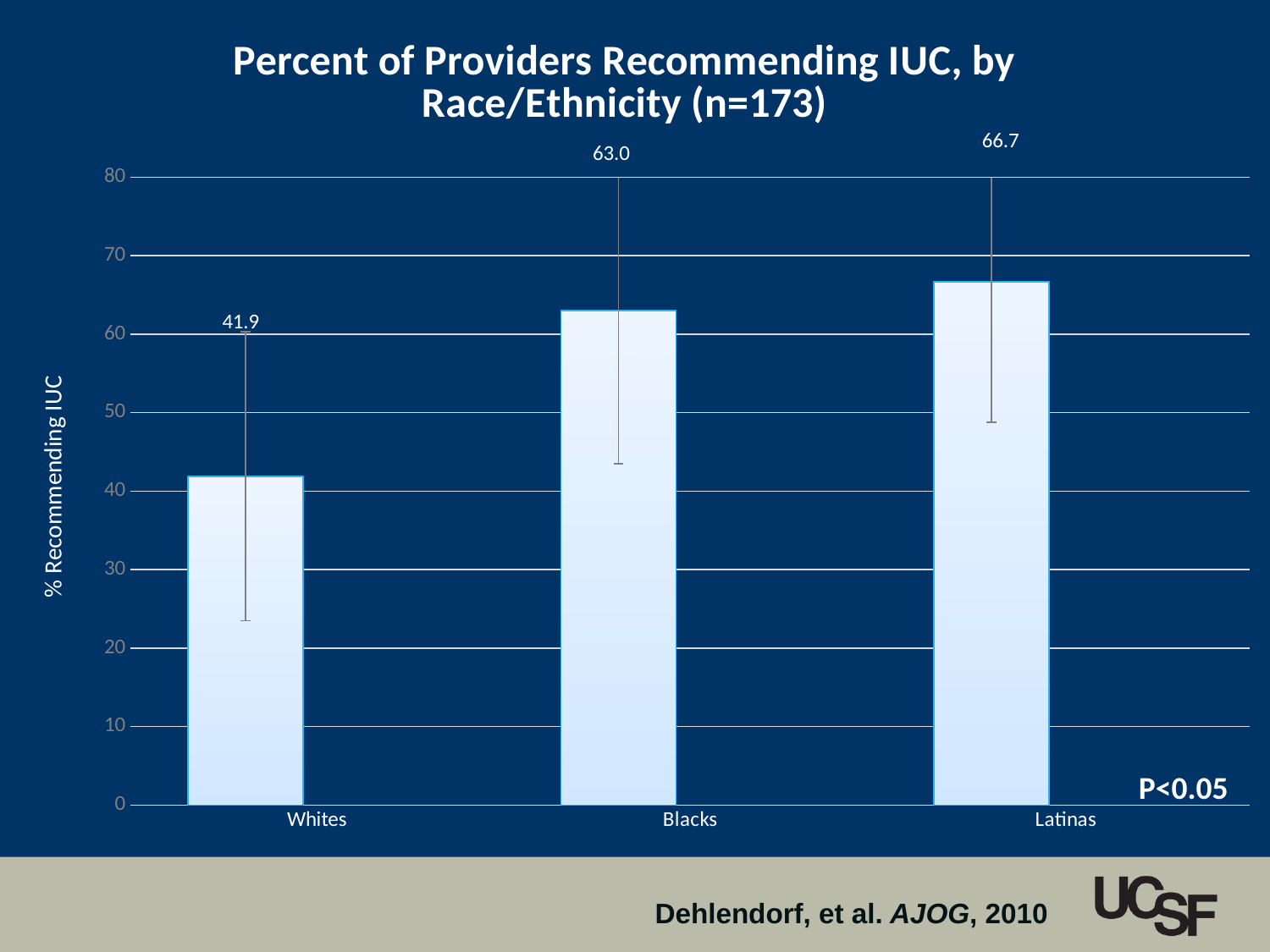
What kind of chart is shown on the slide? bar chart What is the value for Blacks? 63.0 Which category has the highest percent of providers recommending IUC? Latinas What is the difference between the values for Latinas and Whites? 24.8 What is the difference between the values for Blacks and Whites? 21.1 What is the label of the y axis? % Recommending IUC What is the value for Whites? 41.9 What is the value for Latinas? 66.7 Which category has the lowest percent of providers recommending IUC? Whites Which is larger, the value for Whites or the value for Blacks? Blacks Is the value for Whites greater or less than 50? less How many categories are shown on the x axis? 3